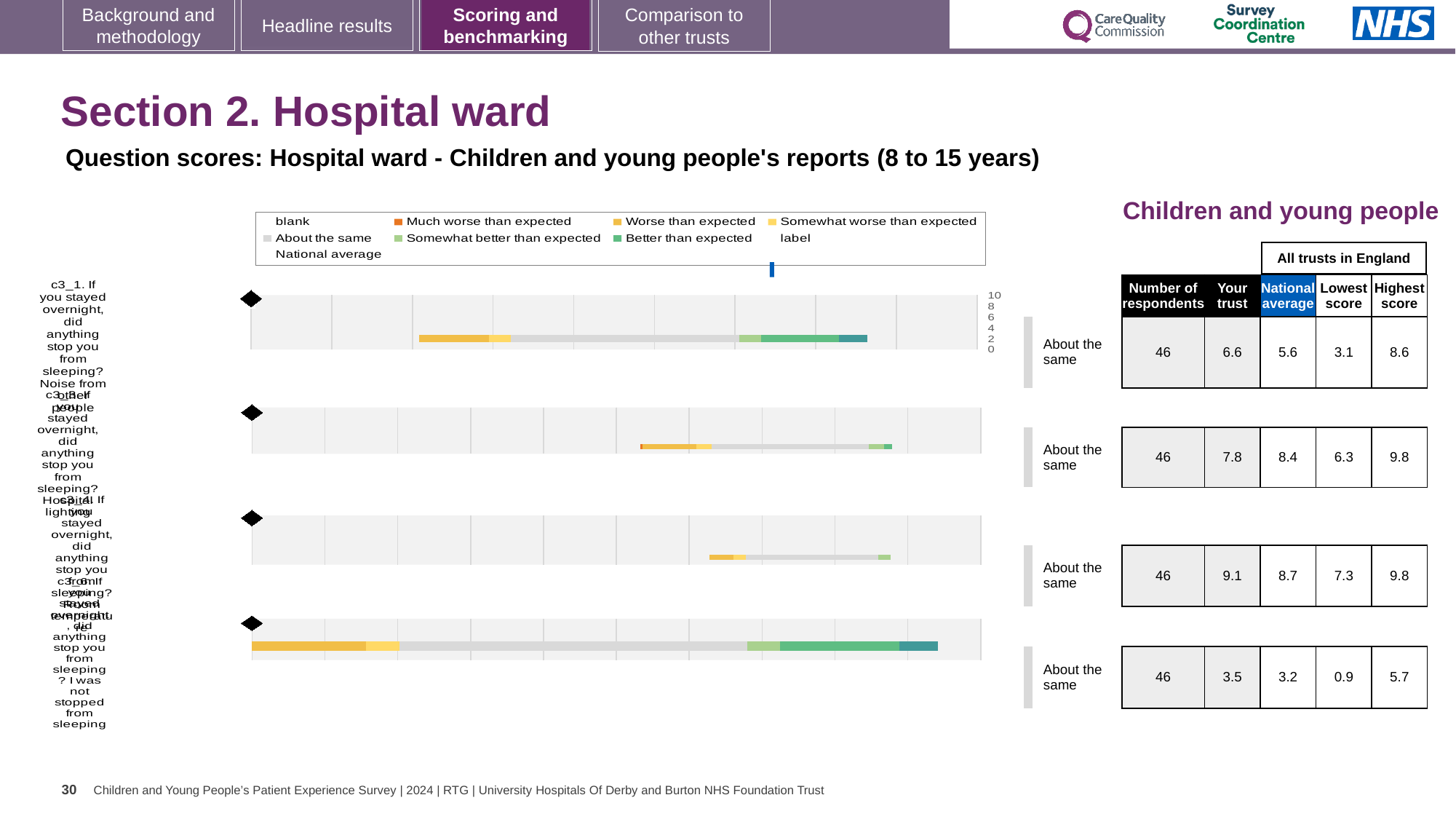
What kind of chart is used for the question scores on this slide? Bar chart (horizontal) For the third chart (c3_4), what is the 'Your trust' score shown in the table? 9.1 For the fourth chart (c3_6, I was not stopped from sleeping), what is the lowest score across all trusts in England? 0.9 For the second chart (c3_3), what is the national average score shown in the table? 8.4 For the first chart (c3_1), what is the difference between the highest score (8.6) and the lowest score (3.1) in the table? 5.5 Which of the four charts has the highest 'Your trust' score in the table? The third chart (c3_4), 9.1 What is the highest value shown on the axis of the first chart? 10 For the first chart (c3_1, noise from other people), what is the 'Your trust' score shown in the table? 6.6 Which legend entry is shown in orange? Much worse than expected For the second chart (c3_3), is the 'Your trust' score (7.8) larger or smaller than the national average (8.4)? Smaller How many separate question-score charts are shown on the slide? 4 Which of the four charts has the lowest 'Your trust' score in the table? The fourth chart (c3_6), 3.5